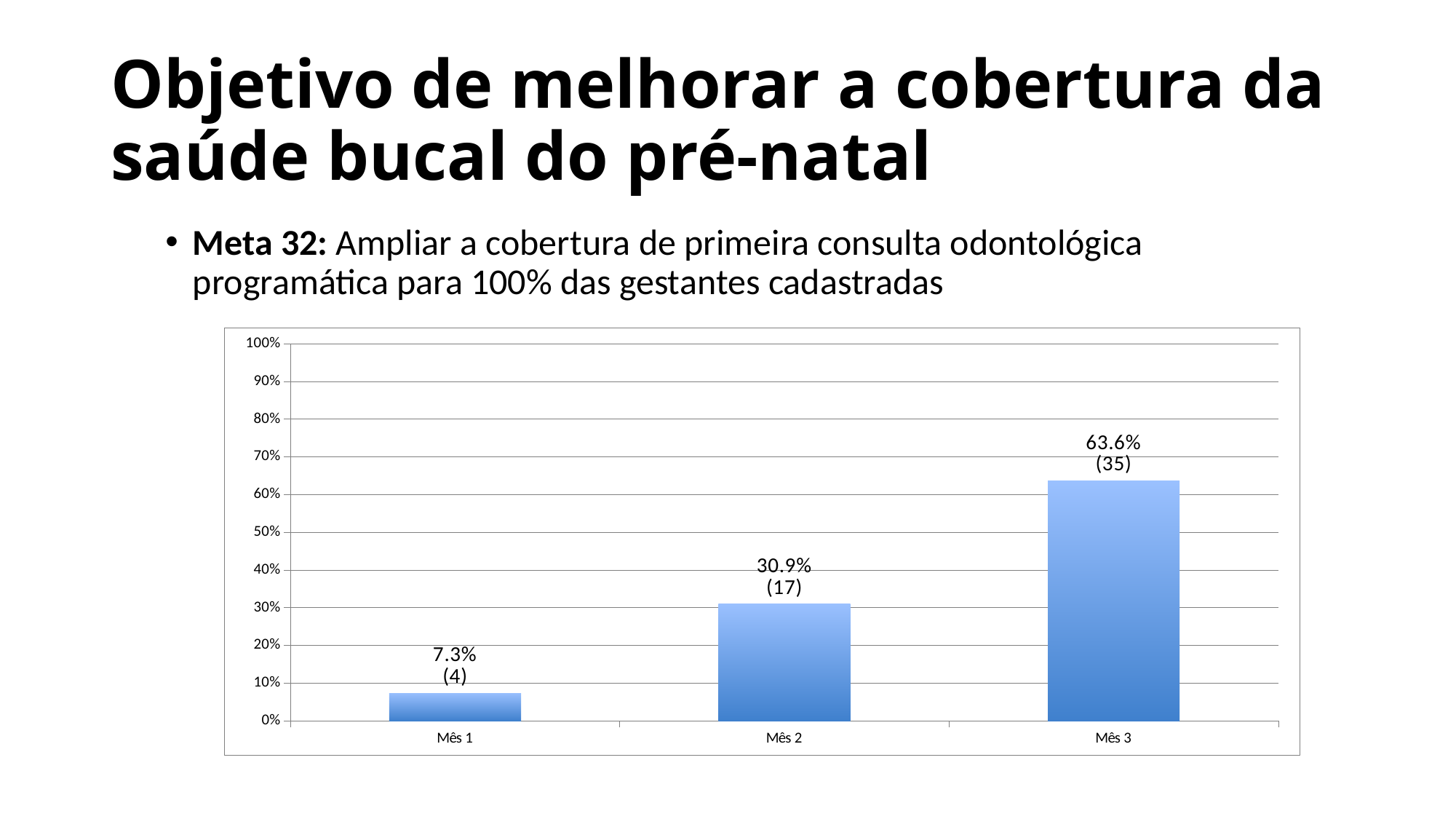
What is the value for Mês 3? 63.6% What is the difference between the values for Mês 2 and Mês 1? 23.6% Which month has the lowest value? Mês 1 What kind of chart is shown? bar chart What is the difference between the values for Mês 3 and Mês 2? 32.7% What is the value for Mês 2? 30.9% What is the value for Mês 1? 7.3% Is the value for Mês 3 greater or less than 50%? greater How many months are shown on the x axis? 3 What count is shown in parentheses for Mês 3? 35 Which is larger, the value for Mês 2 or Mês 1? Mês 2 Which month has the highest value? Mês 3